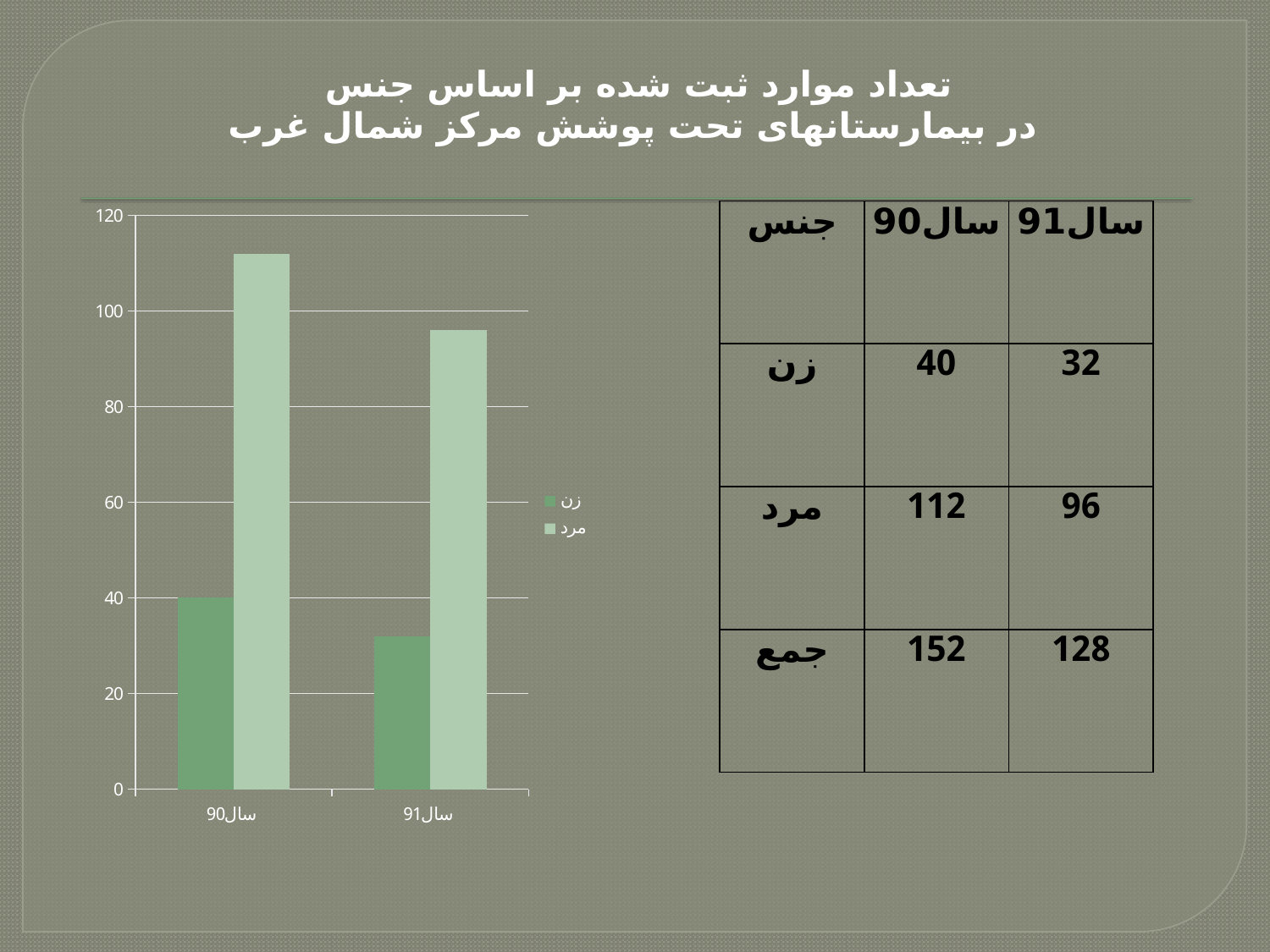
What type of chart is shown on the slide? bar chart Which series is shown in the darker green colour in the chart? زن Is the value for مرد in سال90 greater or less than 100? greater What is the value for مرد in سال90? 112 How many series does the chart legend list? 2 What is the difference between the مرد values for سال90 and سال91? 16 What is the value for زن in سال91? 32 Does the value for زن rise or fall from سال90 to سال91? fall What is the value for زن in سال90? 40 What is the value for مرد in سال91? 96 Which series has the higher value in سال91, زن or مرد? مرد How many categories are shown on the x axis of the chart? 2